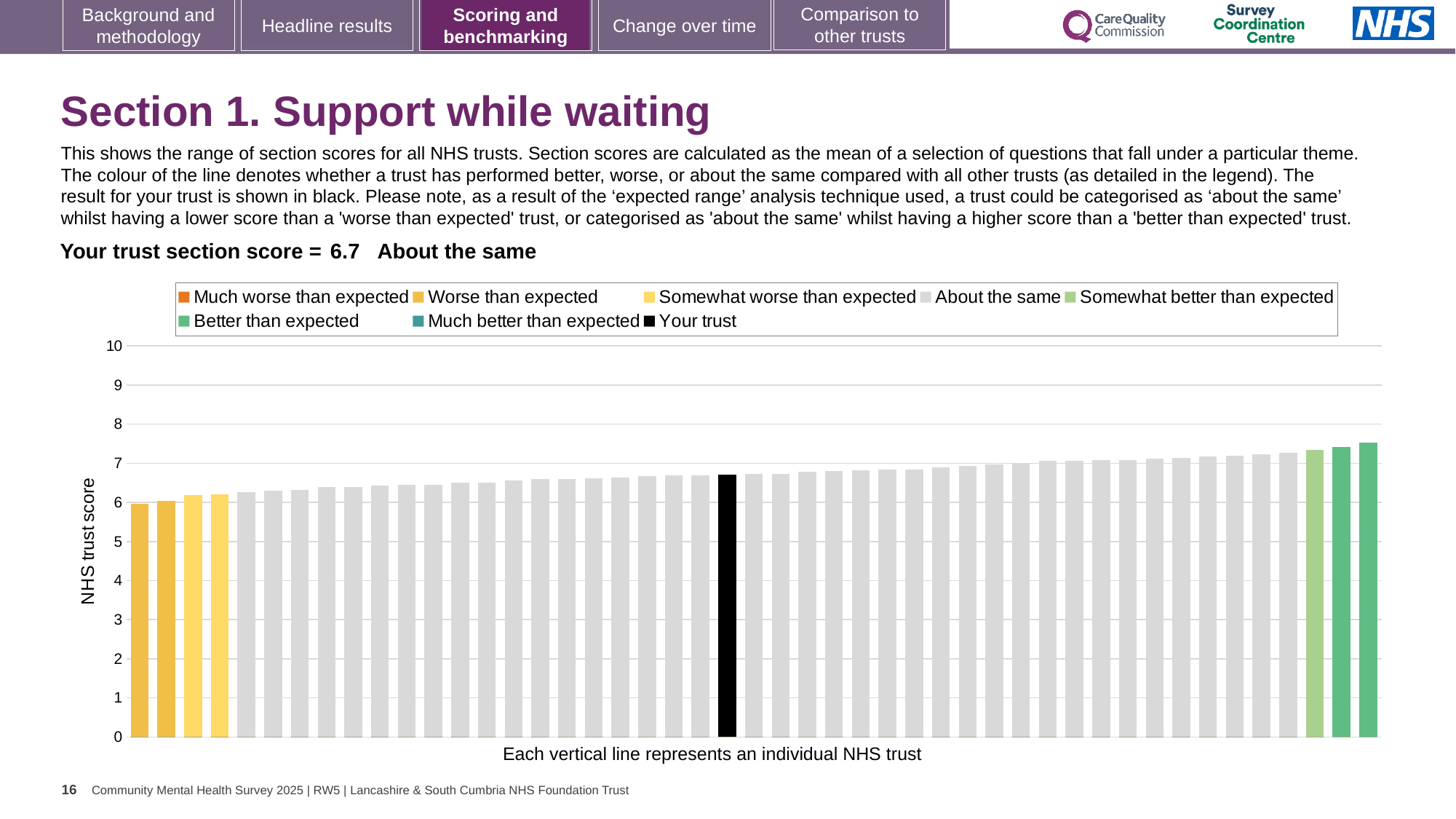
Is the value of the shortest bar greater or less than 5? greater Is the value for your trust greater or less than 5? greater How many entries does the chart legend list? 8 Which legend category does the tallest bar belong to? Better than expected How many bars are coloured as 'Better than expected'? 2 Which legend category is your trust's score placed in? About the same Is your trust's bar higher or lower than the tallest bar on the chart? lower What is the section score for your trust shown on the slide? 6.7 Is the value of the tallest bar greater or less than 7? greater What kind of chart is shown on the slide? bar chart Do the bar values rise or fall from left to right along the x axis? rise What is the label on the vertical axis of the chart? NHS trust score